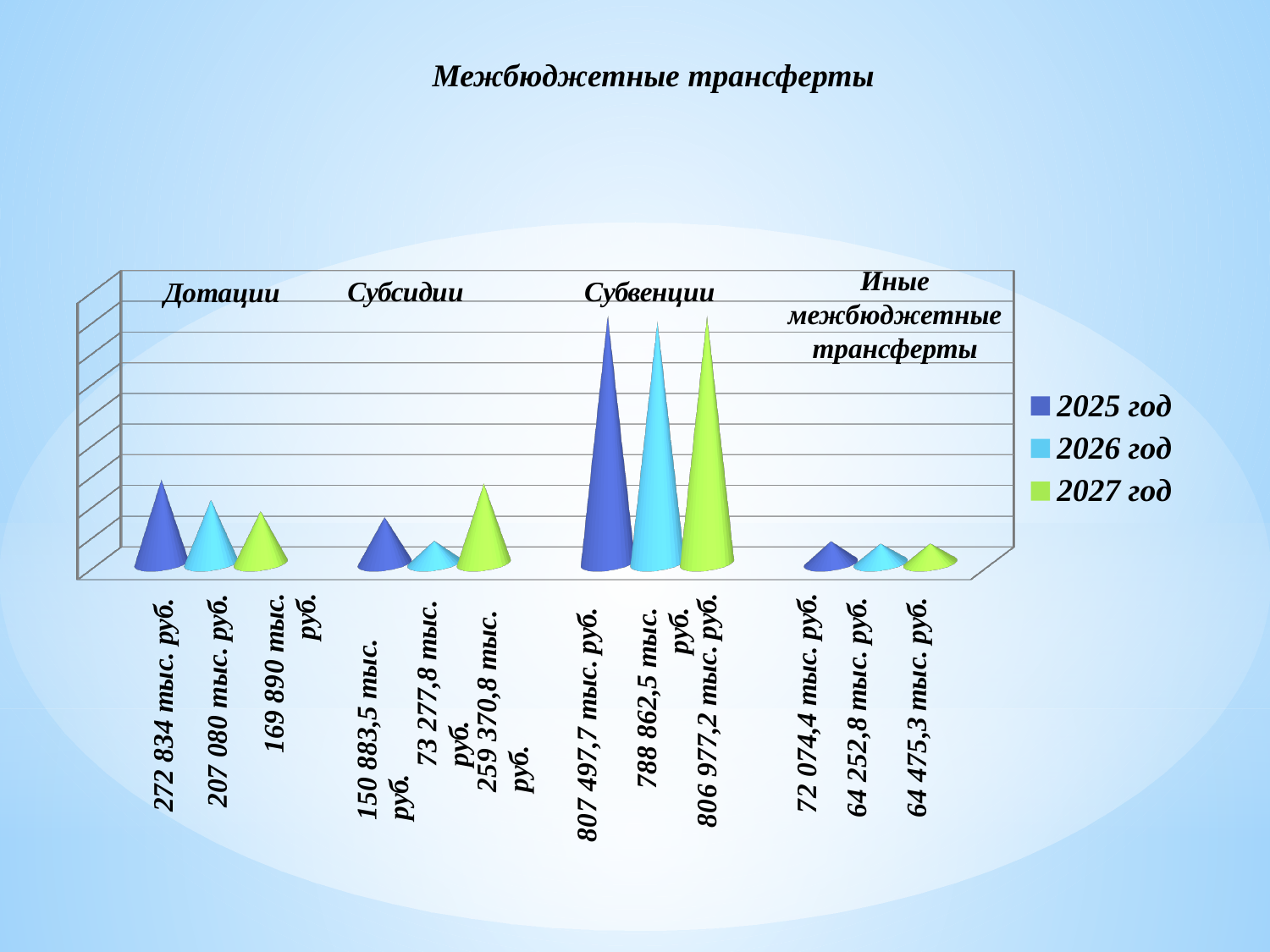
What is the value for Субсидии in 2027 год? 259 370,8 тыс. руб. What is the difference between the 2025 год and 2026 год values for Дотации? 65 754 тыс. руб. What is the value for Дотации in 2025 год? 272 834 тыс. руб. What is the value for Субвенции in 2026 год? 788 862,5 тыс. руб. How many categories are shown on the x axis? 4 Which category has the lowest value in 2026 год? Иные межбюджетные трансферты How many series does the legend list? 3 What is the difference between the 2027 год and 2025 год values for Субсидии? 108 487,3 тыс. руб. Which category has the highest value in 2025 год? Субвенции Which is larger for Субсидии: the 2025 год value or the 2026 год value? 2025 год What is the value for Иные межбюджетные трансферты in 2027 год? 64 475,3 тыс. руб. What is the title of the chart? Межбюджетные трансферты